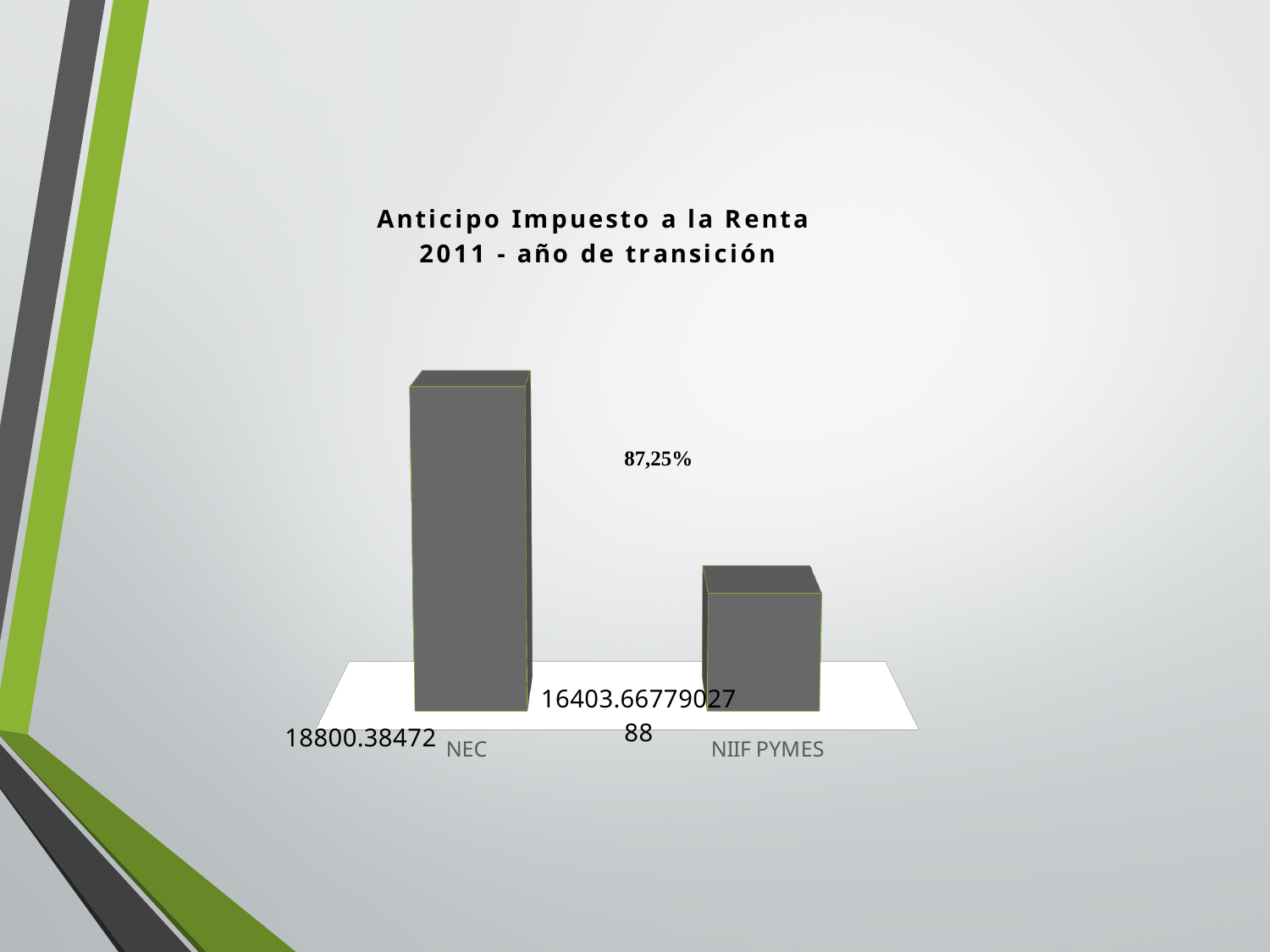
What is the title of the chart? Anticipo Impuesto a la Renta 2011 - año de transición Which is larger, the value for NEC or the value for NIIF PYMES? NEC Which category has the lowest value? NIIF PYMES Which category has the highest value? NEC What is the value shown for NEC? 18800.38472 What is the value shown for NIIF PYMES? 16403.6677902788 Do the values rise or fall from NEC to NIIF PYMES? fall What kind of chart is shown on the slide? bar chart How many categories are plotted in the chart? 2 What percentage is annotated between the two bars on the chart? 87,25%